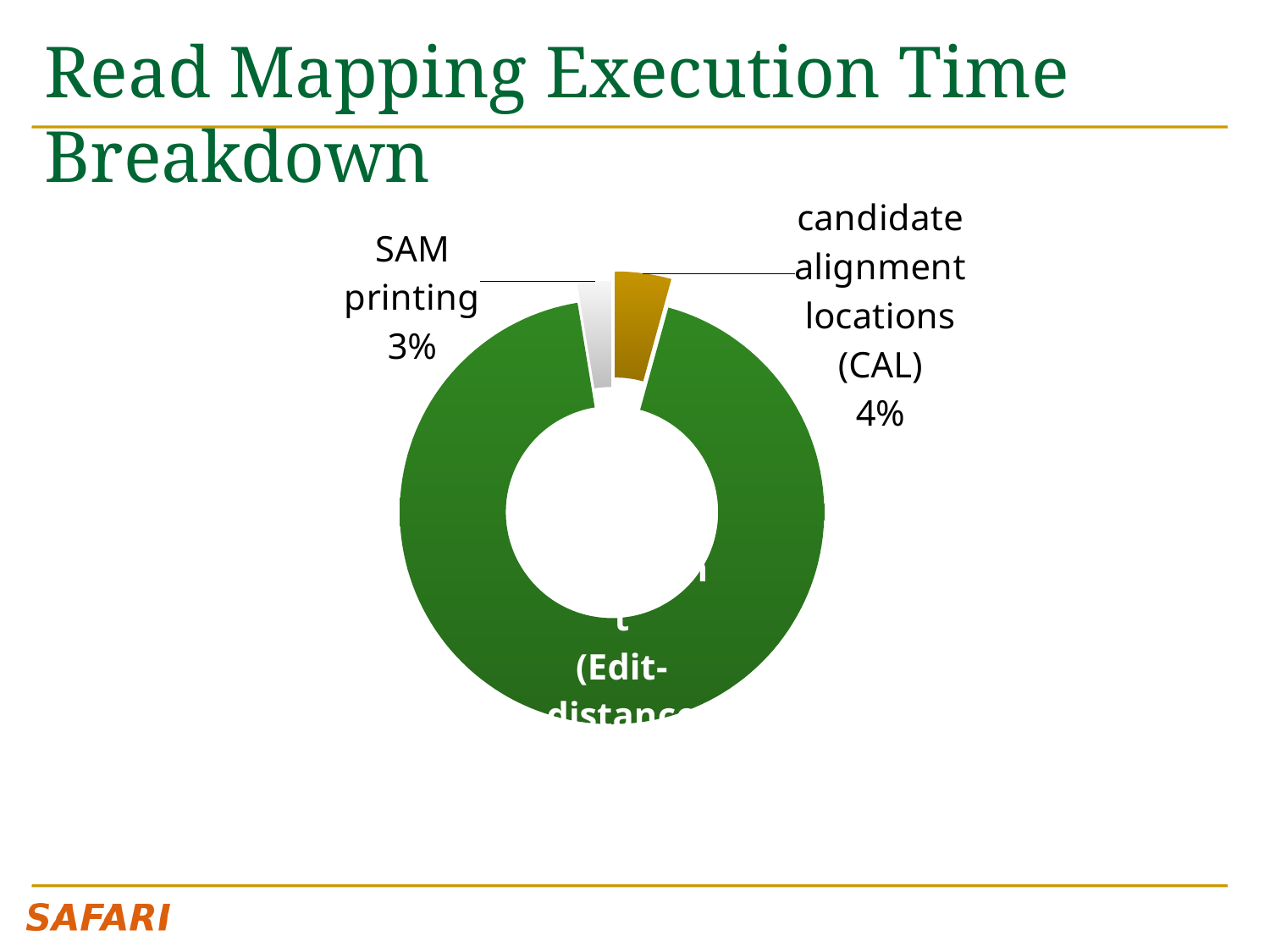
What percentage of execution time is attributed to candidate alignment locations (CAL)? 4% What is the title of the slide containing the chart? Read Mapping Execution Time Breakdown Which labelled category has the smallest share of execution time? SAM printing Which takes a larger share of execution time, SAM printing or candidate alignment locations (CAL)? candidate alignment locations (CAL) What percentage of read mapping execution time is spent on SAM printing? 3% How many slices does the chart contain? 3 What kind of chart is shown on the slide? doughnut chart By how many percentage points does the CAL share exceed the SAM printing share? 1% What colour is the slice representing candidate alignment locations (CAL)? gold